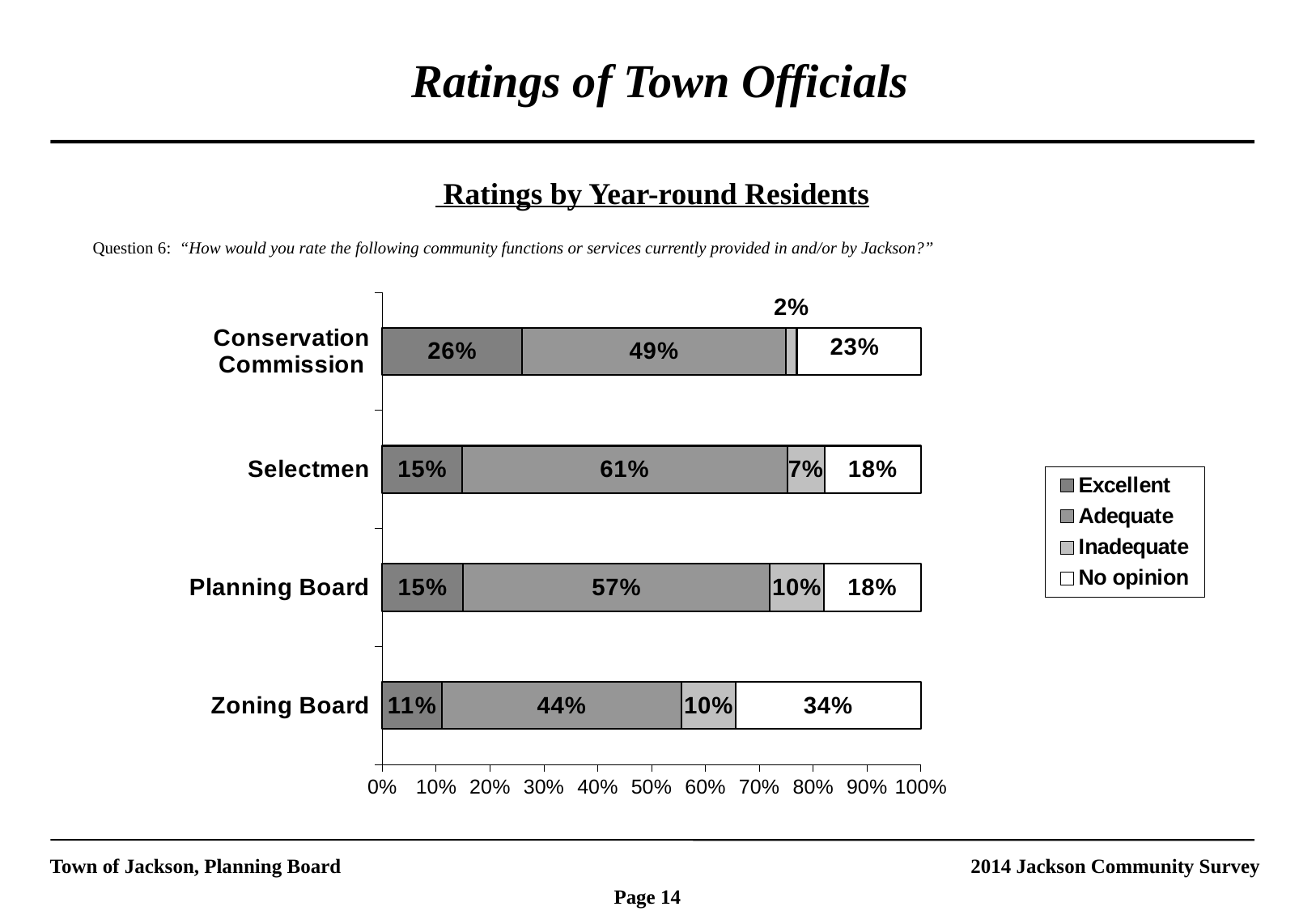
What is the total of the stacked bar for the Planning Board? 100% How many town official groups are shown on the chart? 4 What is the No opinion percentage for the Zoning Board? 34% What kind of chart is shown on the slide? Stacked bar chart Which has a larger No opinion share, the Zoning Board or the Planning Board? Zoning Board What is the difference between the Adequate ratings for the Selectmen and the Zoning Board? 17% What percentage of year-round residents rated the Conservation Commission as Excellent? 26% What is the Inadequate percentage for the Conservation Commission? 2% Which town official group has the highest Excellent rating? Conservation Commission Which town official group has the lowest Adequate rating? Zoning Board What percentage of year-round residents rated the Selectmen as Adequate? 61% How many series does the legend list? 4